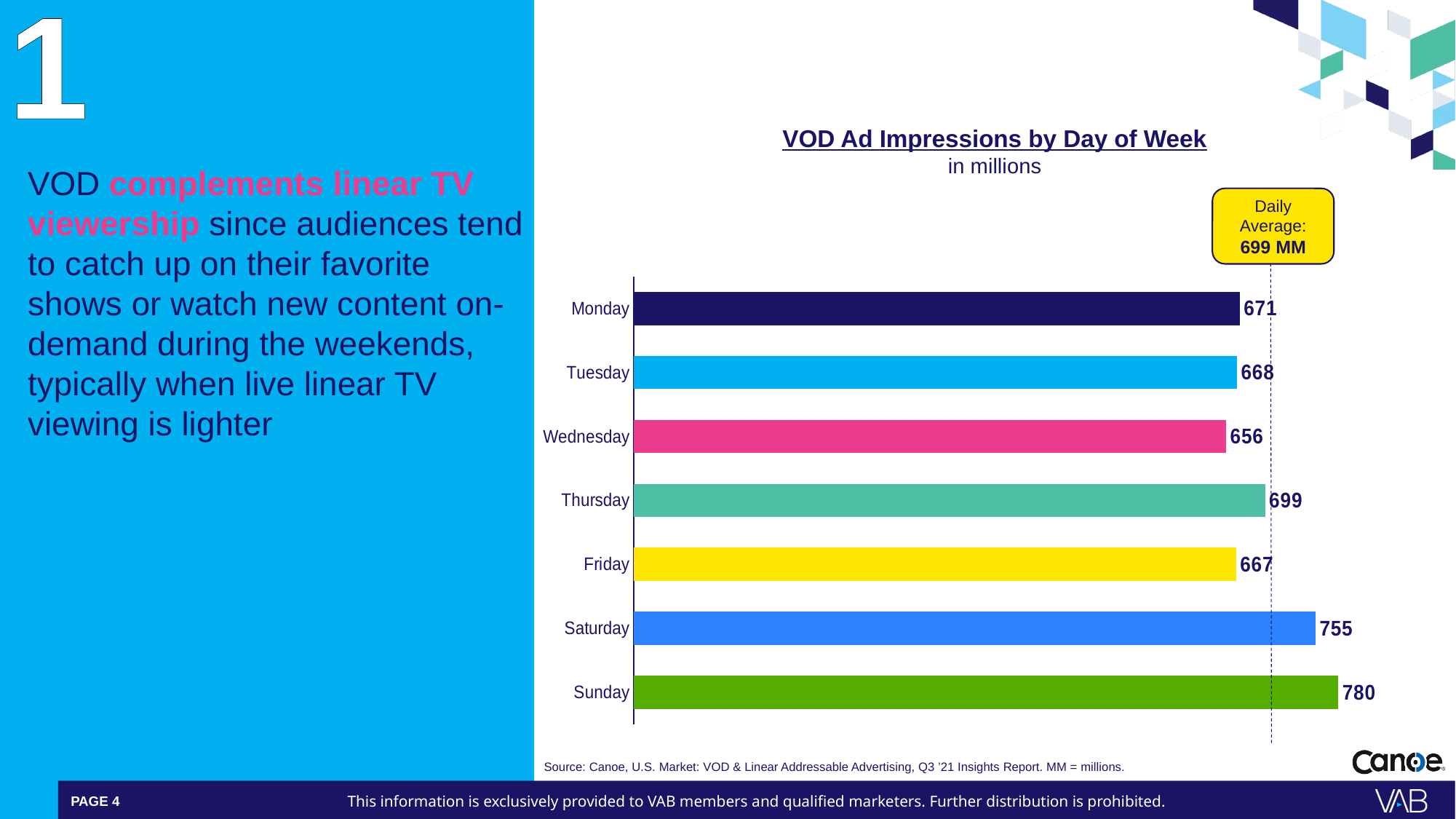
What kind of chart is this? bar chart Which day has the highest VOD ad impressions? Sunday What is the difference between Sunday and Saturday? 25 What is the value for Sunday? 780 What is the title of the chart? VOD Ad Impressions by Day of Week How many days are shown in the chart? 7 Which is larger, Saturday or Friday? Saturday What is the value for Wednesday? 656 What is the daily average shown in the callout? 699 MM What is the value for Thursday? 699 What is the difference between Monday and Wednesday? 15 Which day has the lowest VOD ad impressions? Wednesday